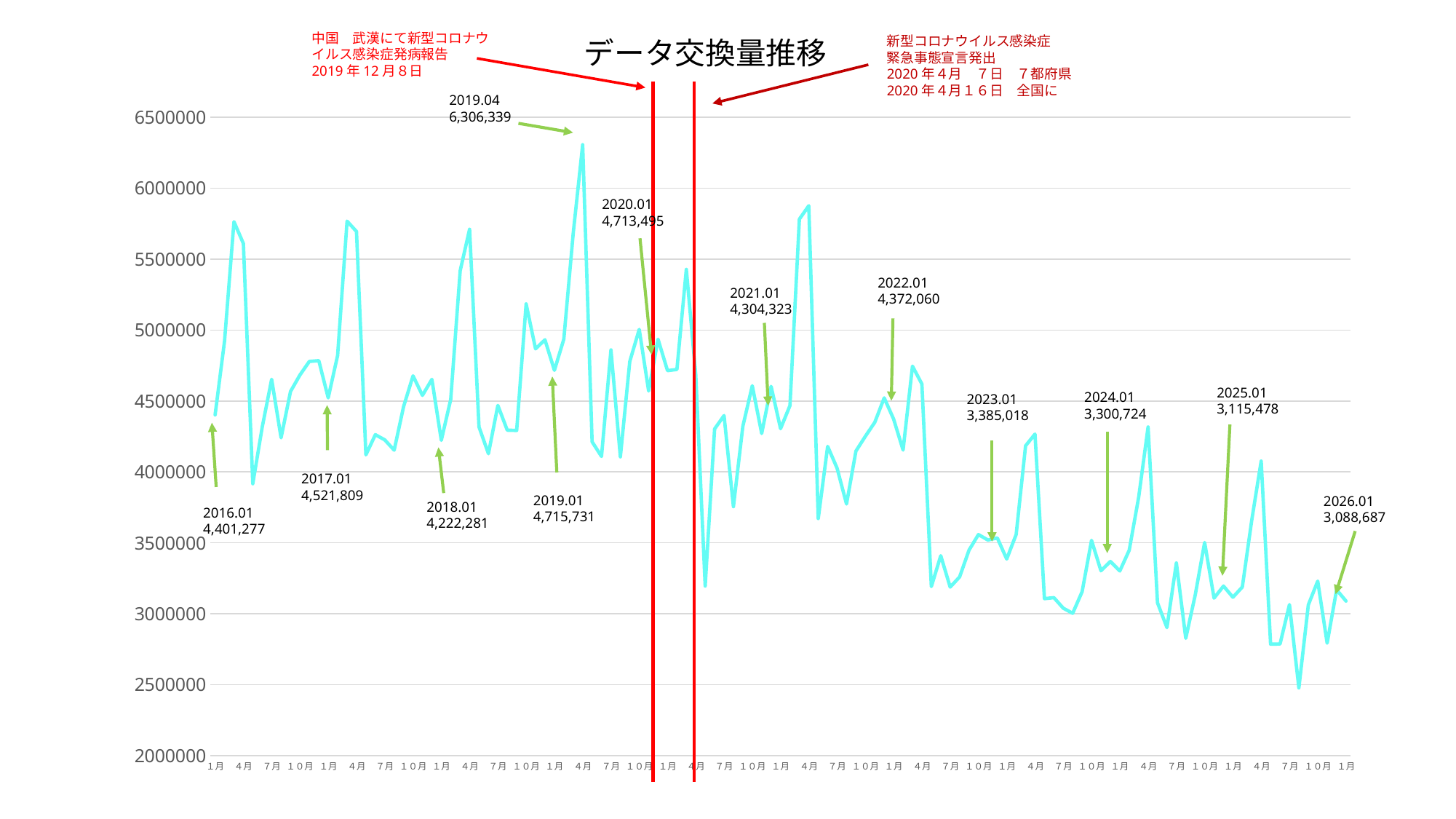
What is the value labelled for 2026.01? 3,088,687 What is the value labelled for 2016.01? 4,401,277 What is the value labelled for 2023.01? 3,385,018 What is the value labelled for 2019.04? 6,306,339 What is the difference between the labelled values for 2016.01 and 2026.01? 1,312,590 What kind of chart is shown on the slide? line chart Which is larger, the labelled value for 2017.01 or for 2018.01? 2017.01 What is the title of the chart? データ交換量推移 Which labelled point has the lowest value? 2026.01 Which labelled point has the highest value? 2019.04 What is the value labelled for 2020.01? 4,713,495 Is the value for 2019.04 greater or less than 6000000? greater